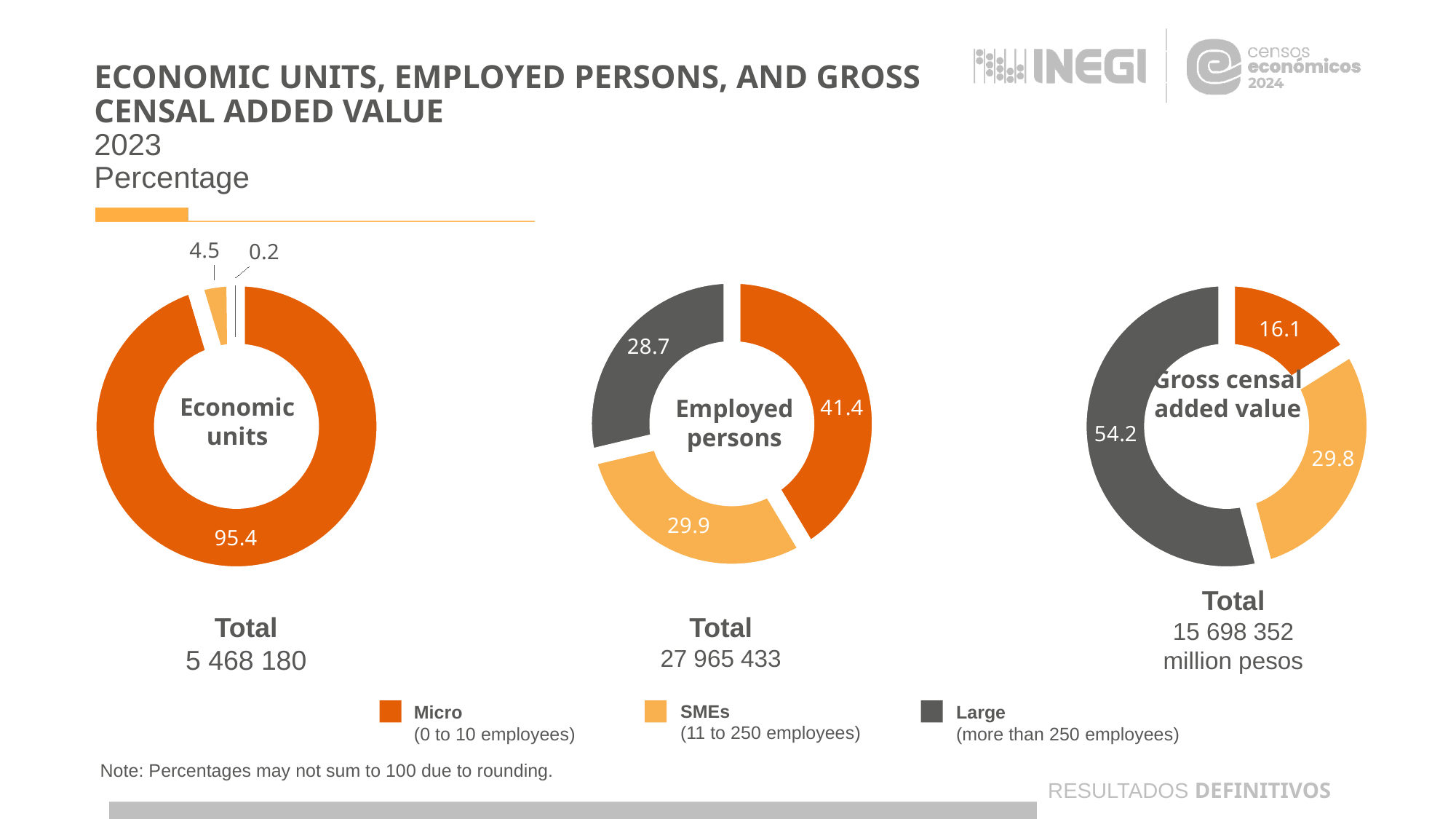
How many categories does the legend list? 3 What is the total shown below the Employed persons chart? 27 965 433 In the Gross censal added value chart, what percentage is shown for Large? 54.2 How many charts are shown on the slide? 3 In the Gross censal added value chart, which is larger, the share for Micro or the share for SMEs? SMEs In the Economic units chart, what percentage is shown for Micro? 95.4 In the Economic units chart, what percentage is shown for Large? 0.2 In the Employed persons chart, which category has the smallest share? Large In the Gross censal added value chart, which category has the largest share? Large In the Employed persons chart, what is the difference between the Micro and Large percentages? 12.7 What type of chart is used on this slide? Doughnut chart In the Employed persons chart, what percentage is shown for SMEs? 29.9